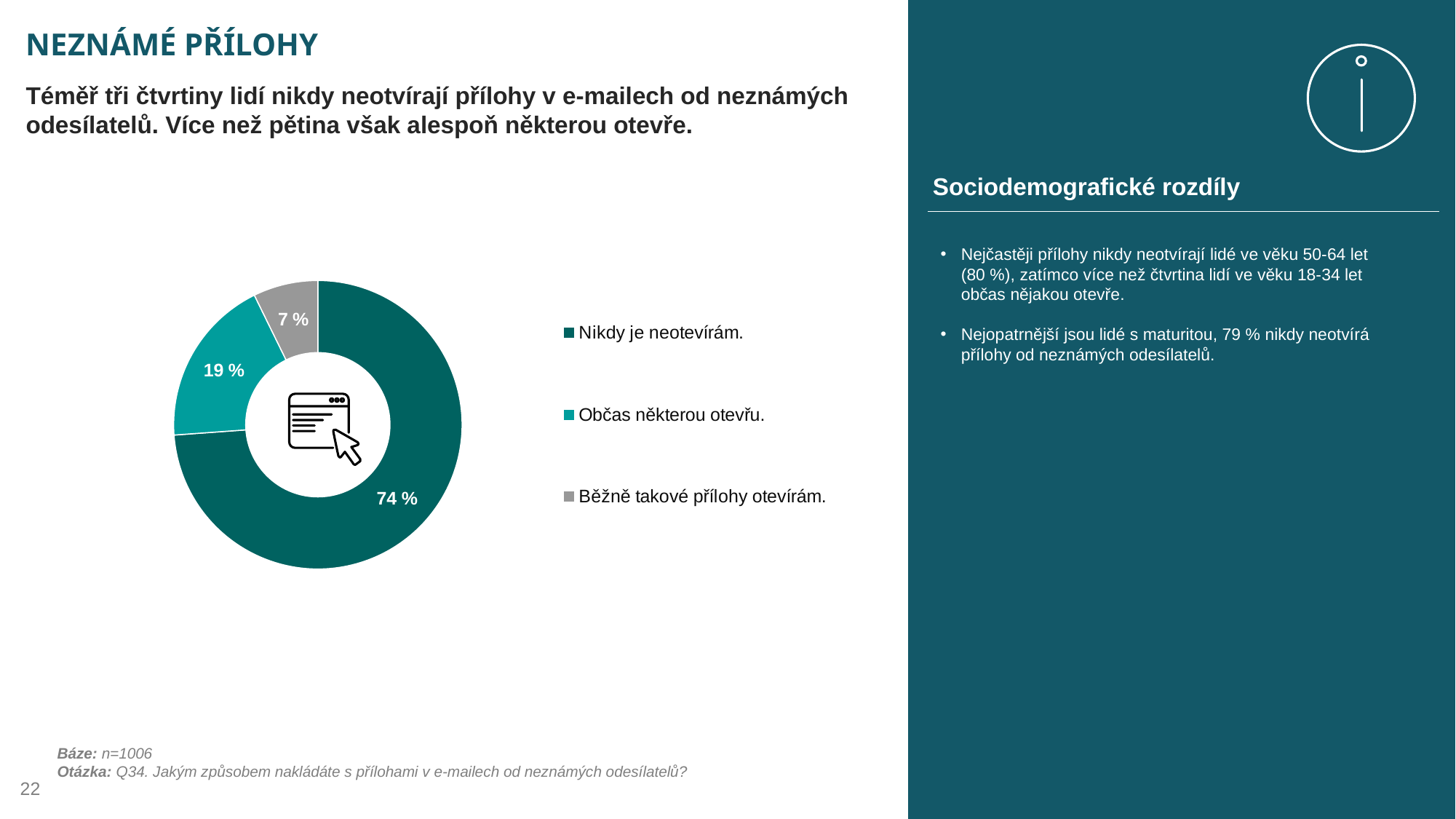
Which category has the largest share of the pie? Nikdy je neotevírám. What share of respondents answered "Občas některou otevřu."? 19 % Which category has the smallest share of the pie? Běžně takové přílohy otevírám. What share of respondents answered "Nikdy je neotevírám."? 74 % How many categories does the chart show? 3 What kind of chart is shown on the slide? Pie chart (doughnut) How many entries does the legend list? 3 Which is larger: the share for "Občas některou otevřu." or for "Běžně takové přílohy otevírám."? Občas některou otevřu. What is the difference in percentage points between "Občas některou otevřu." and "Běžně takové přílohy otevírám."? 12 What colour is the slice for "Běžně takové přílohy otevírám."? Grey What is the difference in percentage points between "Nikdy je neotevírám." and "Občas některou otevřu."? 55 What share of respondents answered "Běžně takové přílohy otevírám."? 7 %